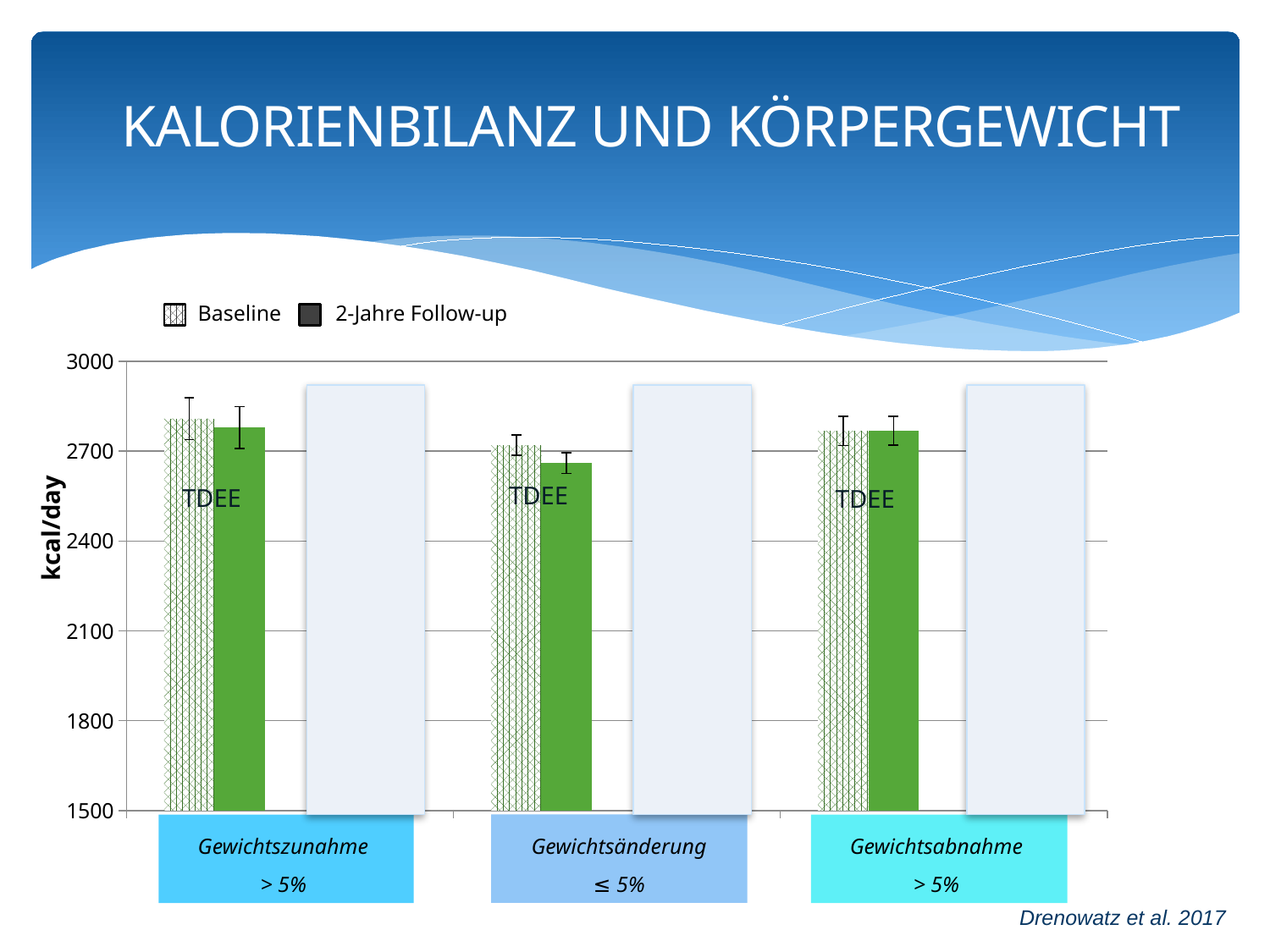
What are the two entries in the chart legend? Baseline and 2-Jahre Follow-up Which is larger: the 2-Jahre Follow-up value for Gewichtsänderung ≤ 5% or the 2-Jahre Follow-up value for Gewichtsabnahme > 5%? 2-Jahre Follow-up value for Gewichtsabnahme > 5% How many series does the legend list? 2 Which group has the lowest 2-Jahre Follow-up value? Gewichtsänderung ≤ 5% Is the 2-Jahre Follow-up value for Gewichtsänderung ≤ 5% greater or less than 2700? less What is the label of the y axis? kcal/day Is the Baseline value for Gewichtszunahme > 5% greater or less than 2700? greater What kind of chart is shown on the slide? bar chart Is the 2-Jahre Follow-up value for Gewichtszunahme > 5% greater or less than 2400? greater How many weight-change groups are shown on the x axis? 3 Which is larger: the Baseline value for Gewichtszunahme > 5% or the 2-Jahre Follow-up value for Gewichtsänderung ≤ 5%? Baseline value for Gewichtszunahme > 5%